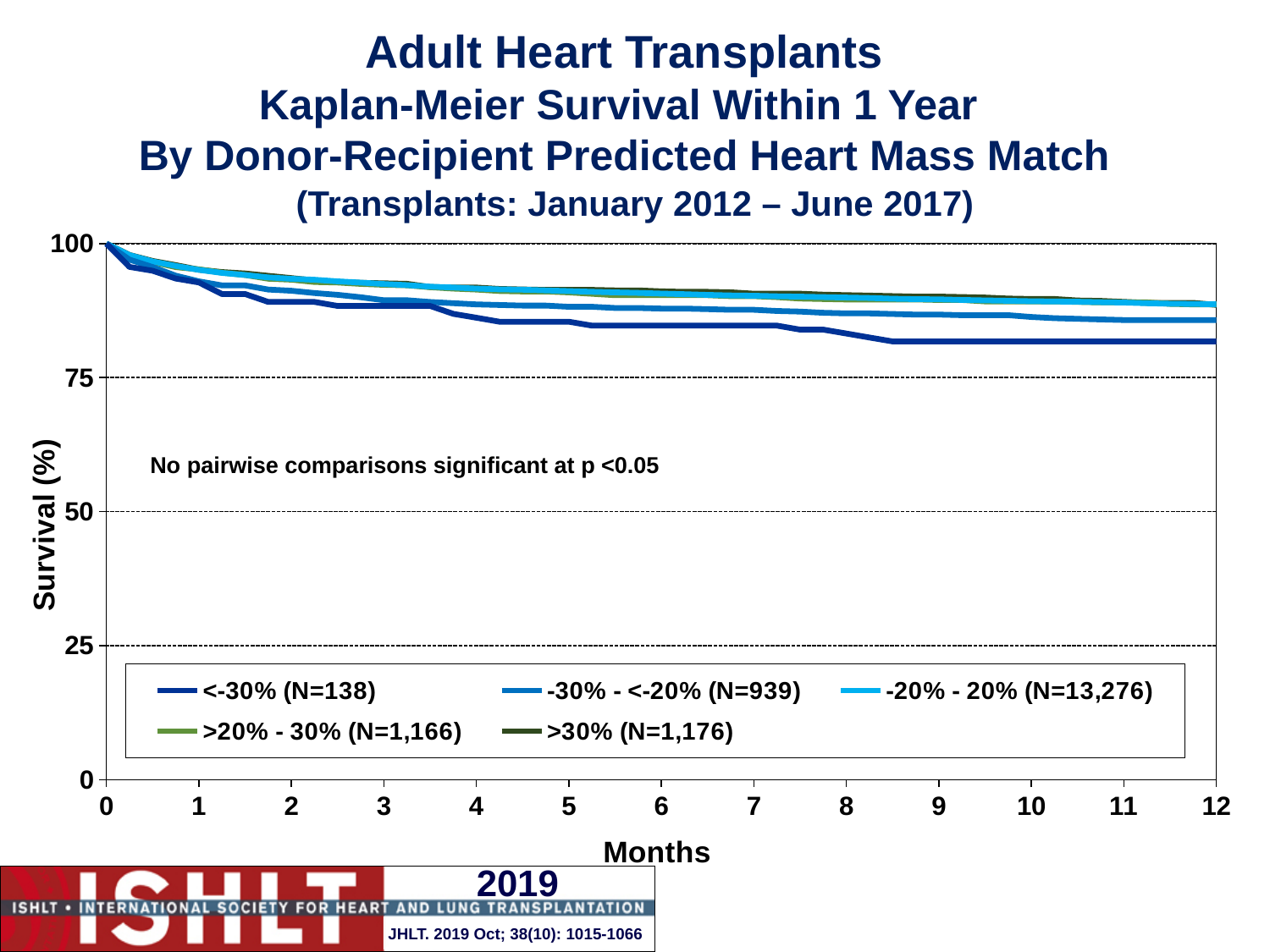
Is the survival for the -20% - 20% group at 12 months greater or less than 100? less Which group has the lowest survival at 12 months? <-30% (N=138) What kind of chart is shown on the slide? line chart Is the survival for the <-30% group at 9 months greater or less than 50? greater Is the survival for the >30% group at 6 months greater or less than 75? greater At 12 months, which group has higher survival: <-30% or -30% - <-20%? -30% - <-20% According to the legend, what is the N for the <-30% group? 138 How many series does the legend list? 5 Do the survival curves rise or fall as months increase along the x axis? fall According to the legend, what is the N for the -20% - 20% group? 13,276